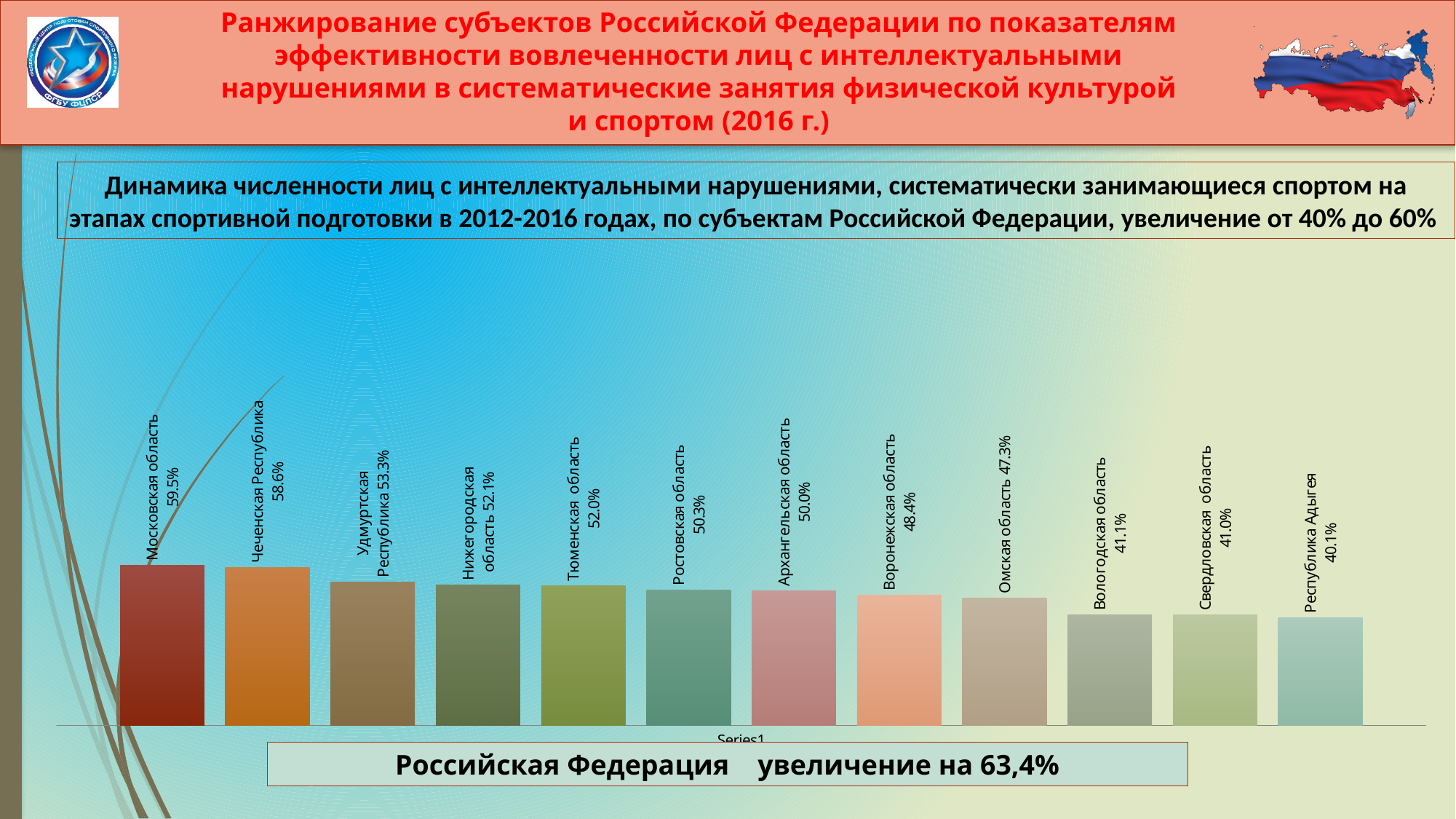
Which is larger, the value for Архангельская область or the value for Воронежская область? Архангельская область What is the value for Республика Адыгея? 40.1% Do the values rise or fall from left to right along the x axis? Fall What is the difference between the values for Удмуртская Республика and Вологодская область? 12.2% What is the value for Омская область? 47.3% Which region has the lowest value on the chart? Республика Адыгея What is the value for Московская область? 59.5% What is the value for Ростовская область? 50.3% What kind of chart is shown on the slide? Bar chart What is the difference between the values for Московская область and Чеченская Республика? 0.9% How many regions are shown on the chart? 12 Which region has the highest value on the chart? Московская область